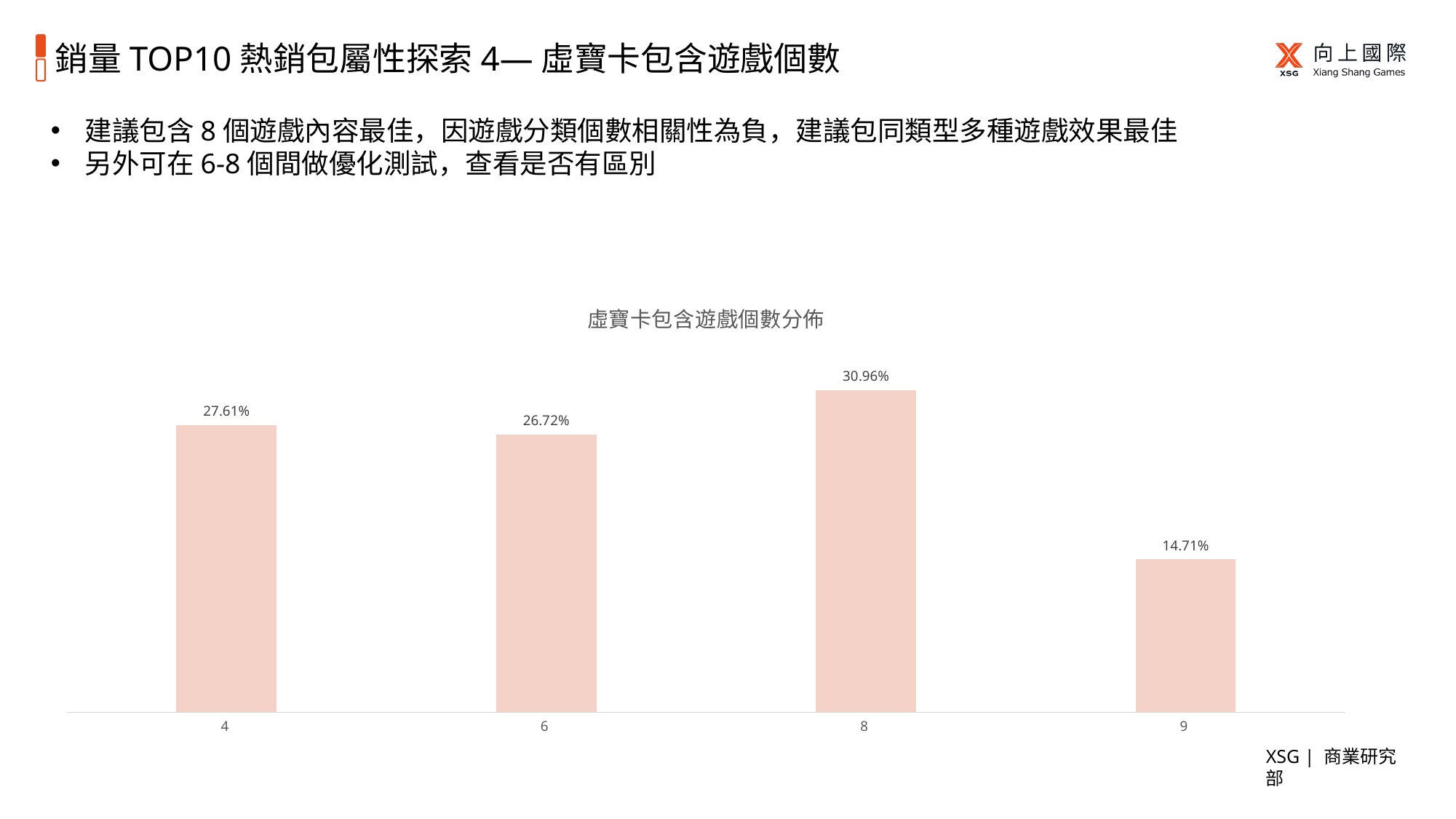
How many categories are shown on the x axis? 4 Which category has the highest value? 8 What is the title of the chart? 虛寶卡包含遊戲個數分佈 What is the value for category 9? 14.71% What is the value for category 8? 30.96% What is the difference between the values for category 8 and category 9? 16.25% What is the difference between the values for category 4 and category 6? 0.89% What is the value for category 4? 27.61% Which is larger, the value for category 8 or the value for category 4? 8 What is the value for category 6? 26.72% Which category has the lowest value? 9 What kind of chart is shown on the slide? Bar chart